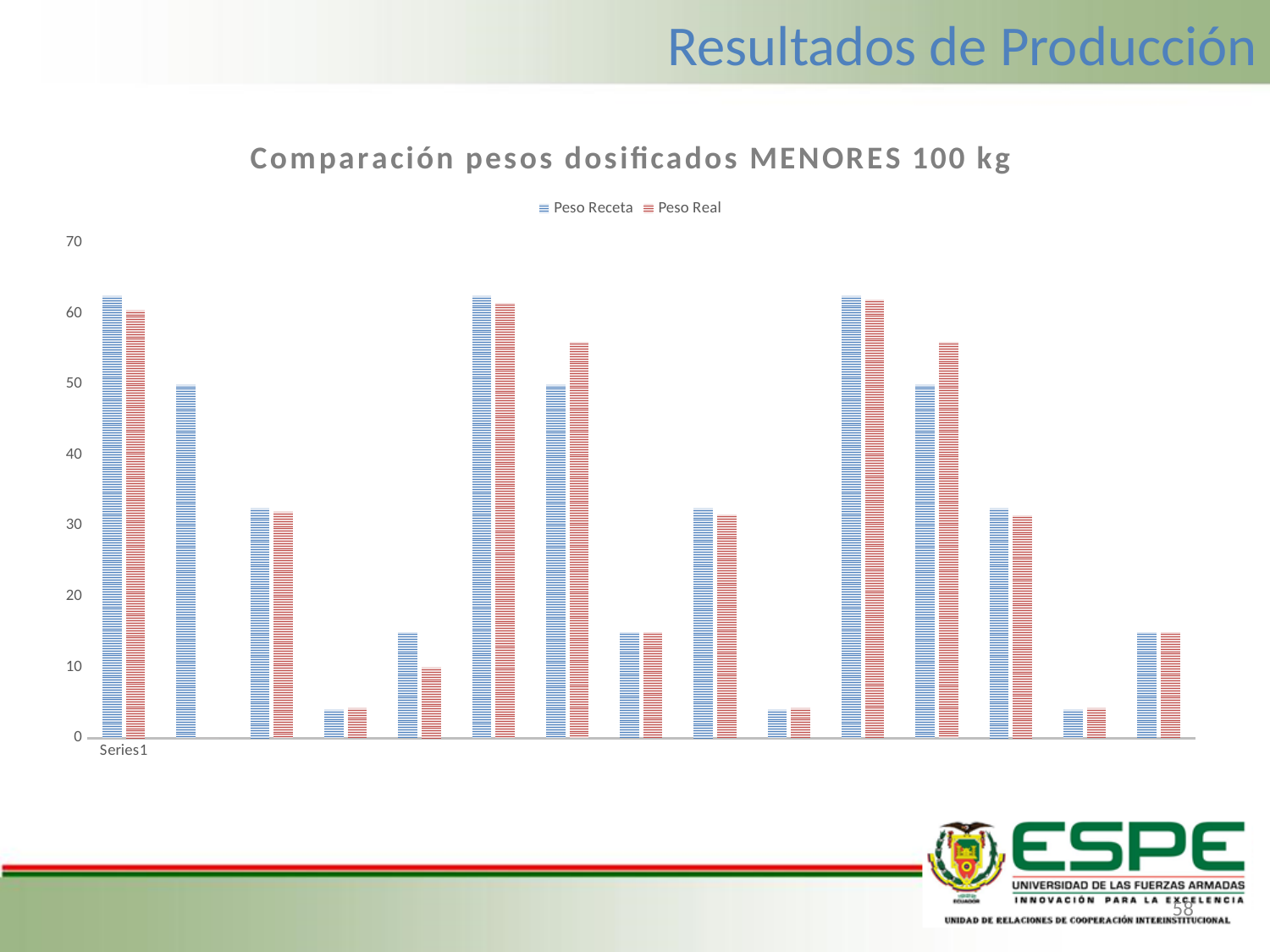
How many series does the chart legend list? 2 How many groups of bars are plotted in the chart? 15 What type of chart is shown on the slide? bar chart Is the tallest Peso Receta bar greater or less than 60? greater What are the names of the two series in the legend? Peso Receta and Peso Real Is the shortest Peso Real bar greater or less than 10? less What is the maximum value shown on the vertical axis? 70 Is the tallest Peso Real bar greater or less than 60? greater What is the title of the chart? Comparación pesos dosificados MENORES 100 kg